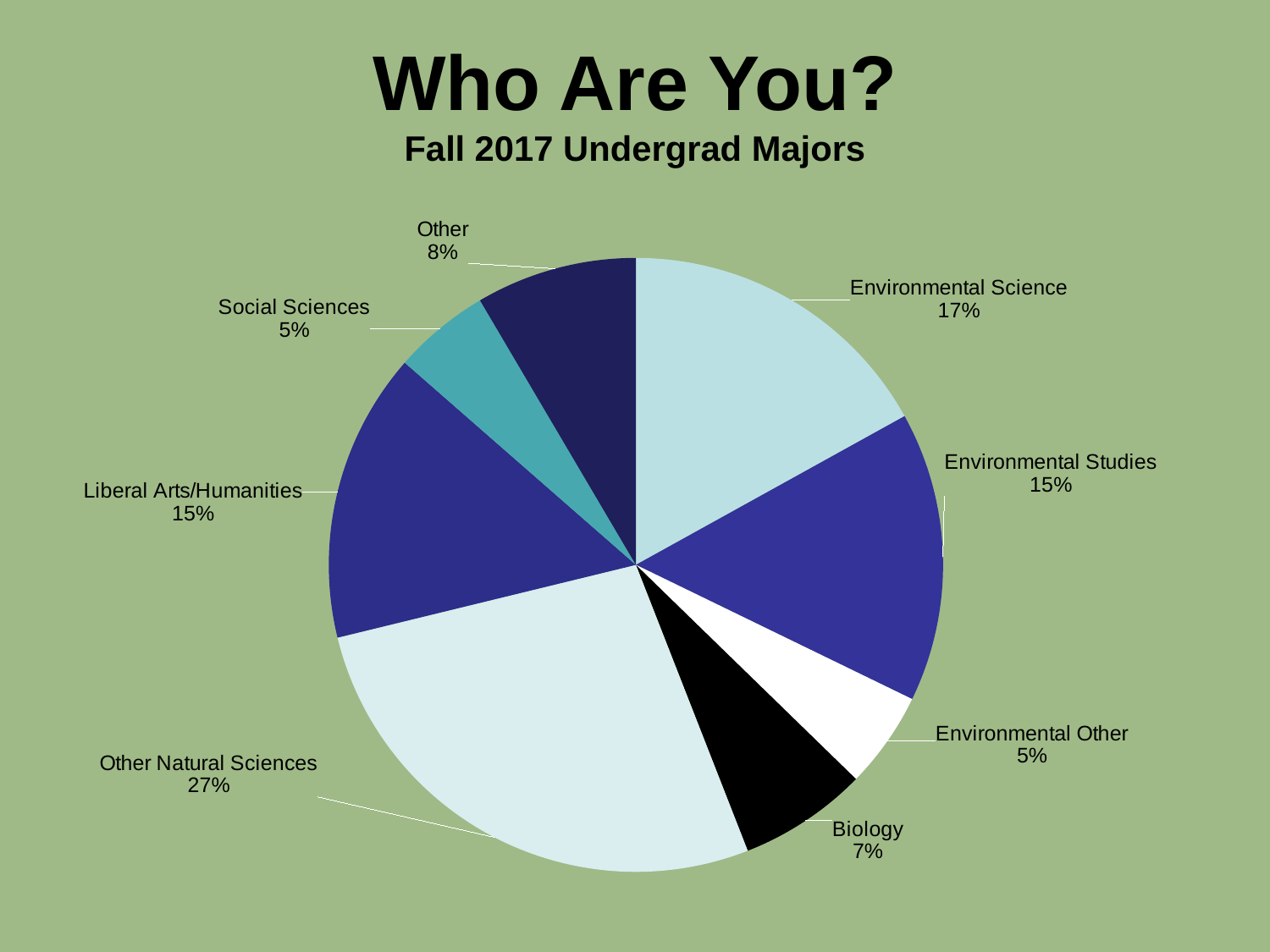
What is the subtitle of the chart on the slide? Fall 2017 Undergrad Majors What percentage of the pie is Other Natural Sciences? 27% What is the value shown for Other? 8% Which major category has the largest share of the pie? Other Natural Sciences Which category has a larger share, Environmental Science or Biology? Environmental Science What share of Fall 2017 undergrad majors is Environmental Science? 17% What is the difference in percentage points between Other Natural Sciences and Environmental Studies? 12 How many categories are shown in the pie chart? 8 What kind of chart is shown on the slide? Pie chart What is the value shown for Biology? 7% What percentage is shown for Liberal Arts/Humanities? 15%